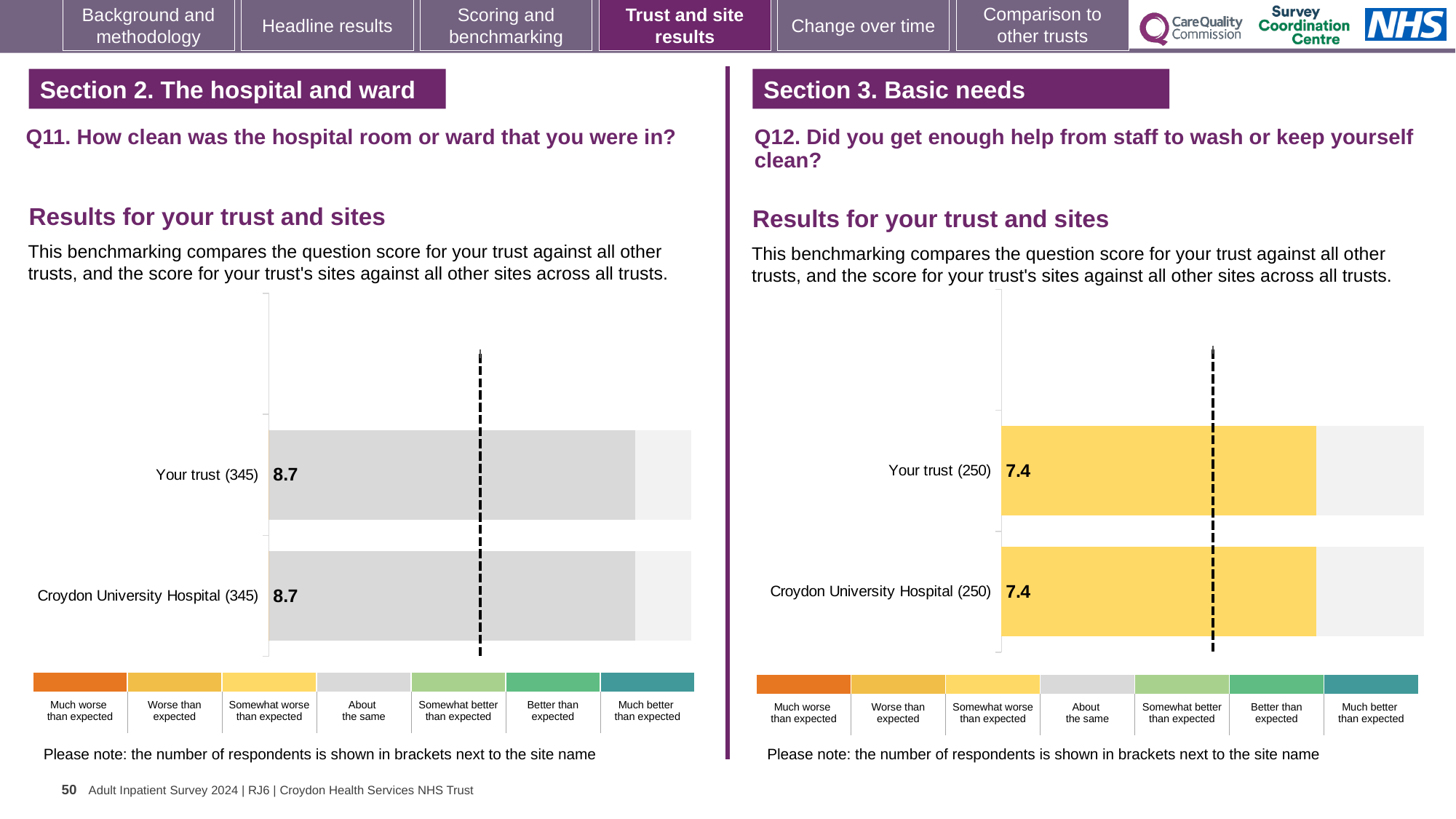
In the Q11 chart on the left, what is the score for Croydon University Hospital? 8.7 How many bars are plotted in the Q12 chart on the right? 2 According to the colour key, which benchmark category do the yellow bars in the Q12 chart on the right represent? Somewhat worse than expected What kind of chart is used for the Q11 results on the left? Bar chart How many bars are plotted in the Q11 chart on the left? 2 In the Q12 chart on the right, what is the score for Your trust? 7.4 In the Q11 chart on the left, how many respondents are shown in brackets for Your trust? 345 In the Q12 chart on the right, what is the difference between the score for Your trust and the score for Croydon University Hospital? 0 In the Q12 chart on the right, how many respondents are shown in brackets for Croydon University Hospital? 250 In the Q12 chart on the right, what is the score for Croydon University Hospital? 7.4 In the Q11 chart on the left, what is the difference between the score for Your trust and the score for Croydon University Hospital? 0 In the Q11 chart on the left, what is the score for Your trust? 8.7